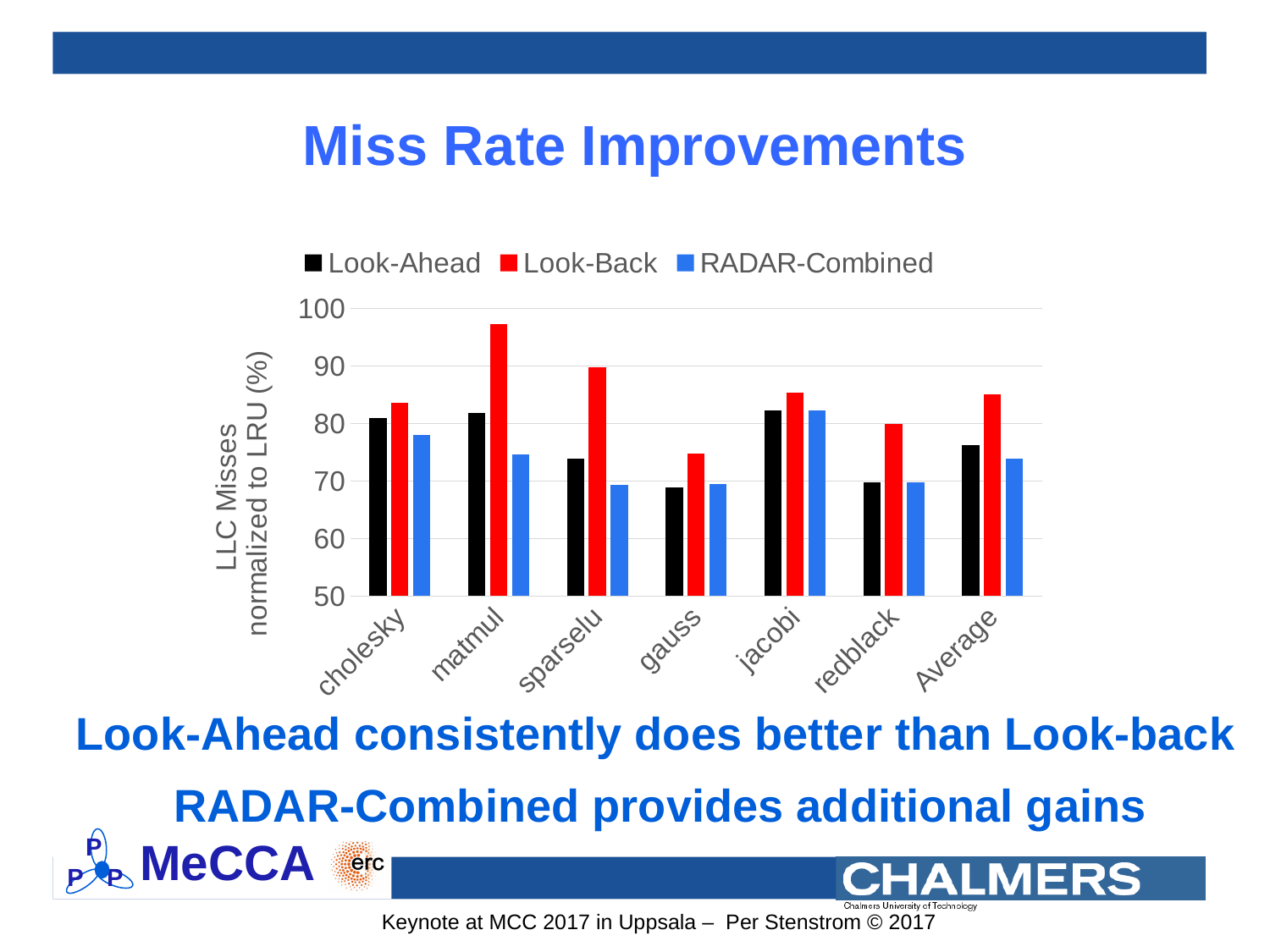
For sparselu, which is larger: the Look-Ahead value or the RADAR-Combined value? Look-Ahead Is the RADAR-Combined value for cholesky greater or less than 80? less For matmul, which is larger: the Look-Ahead value or the Look-Back value? Look-Back For which category is the Look-Back value highest? matmul How many categories are shown on the x axis? 7 Is the Look-Back value for sparselu greater or less than 80? greater How many series does the legend list? 3 Is the Look-Ahead value for sparselu greater or less than 80? less What kind of chart is shown on the slide? bar chart What is the label on the y axis of the chart? LLC Misses normalized to LRU (%)